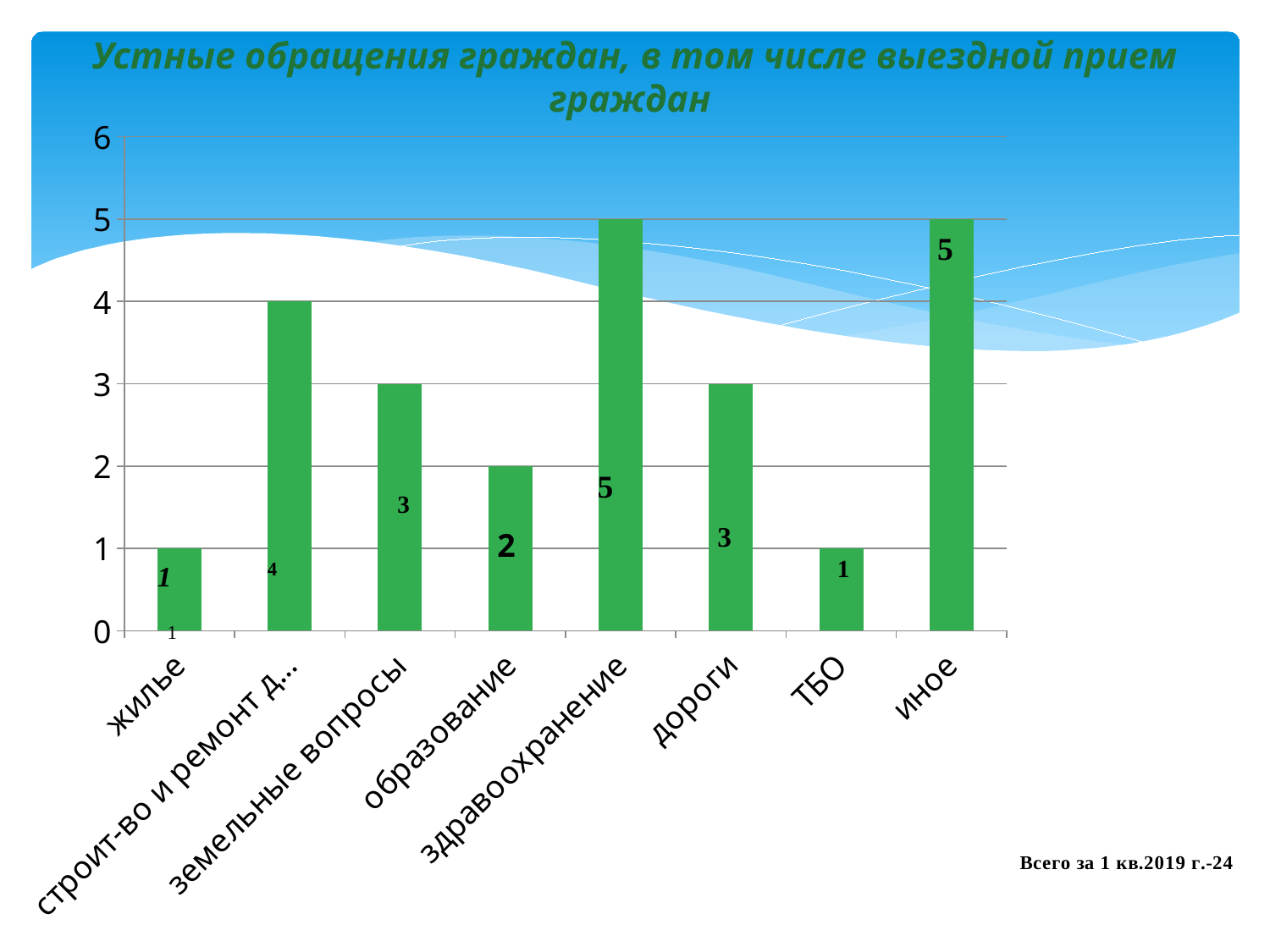
Which is larger, the value for дороги or the value for образование? дороги What kind of chart is shown on the slide? bar chart What is the value for the category labelled 'строит-во и ремонт д...'? 4 How many categories are shown on the x axis? 8 What is the value for образование? 2 What is the title of the chart? Устные обращения граждан, в том числе выездной прием граждан What is the value for земельные вопросы? 3 Is the value for здравоохранение greater or less than 4? greater What is the difference between the values for иное and жилье? 4 Which two categories share the highest value on the chart? здравоохранение and иное What is the value for ТБО? 1 What is the value for здравоохранение? 5